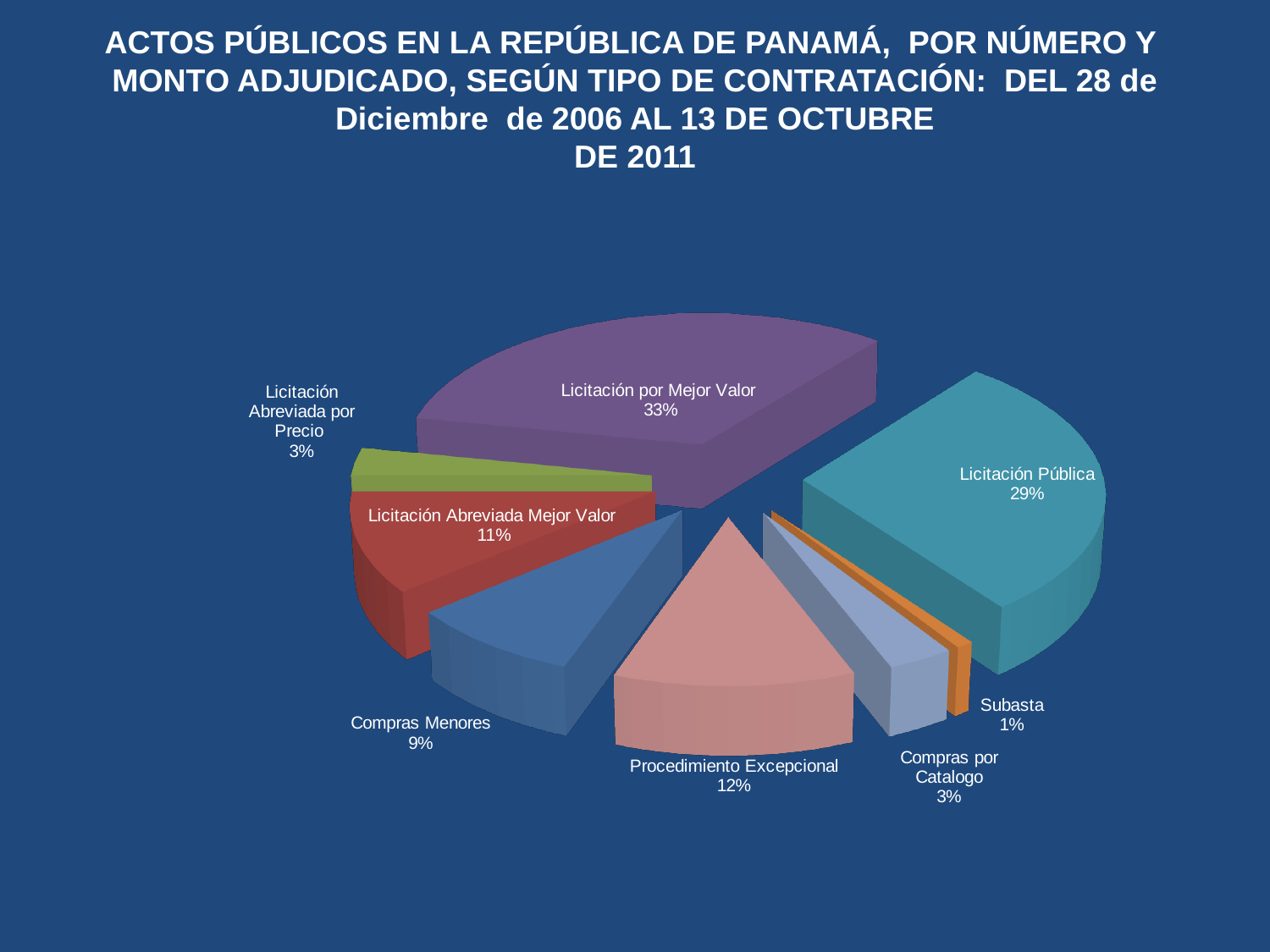
What percentage is shown for Subasta? 1% How many slices does the pie chart have? 8 What type of chart is shown on the slide? Pie chart What percentage is shown for Compras Menores? 9% What percentage is shown for Procedimiento Excepcional? 12% What is the difference in percentage points between Licitación por Mejor Valor and Licitación Pública? 4 What percentage is shown for Licitación Pública? 29% Which type of contracting has the smallest share of the pie? Subasta Which type of contracting has the largest share of the pie? Licitación por Mejor Valor Which two categories each have a share of 3%? Licitación Abreviada por Precio and Compras por Catalogo Which is larger, the share for Procedimiento Excepcional or the share for Licitación Abreviada Mejor Valor? Procedimiento Excepcional What share of the pie does Licitación por Mejor Valor represent? 33%